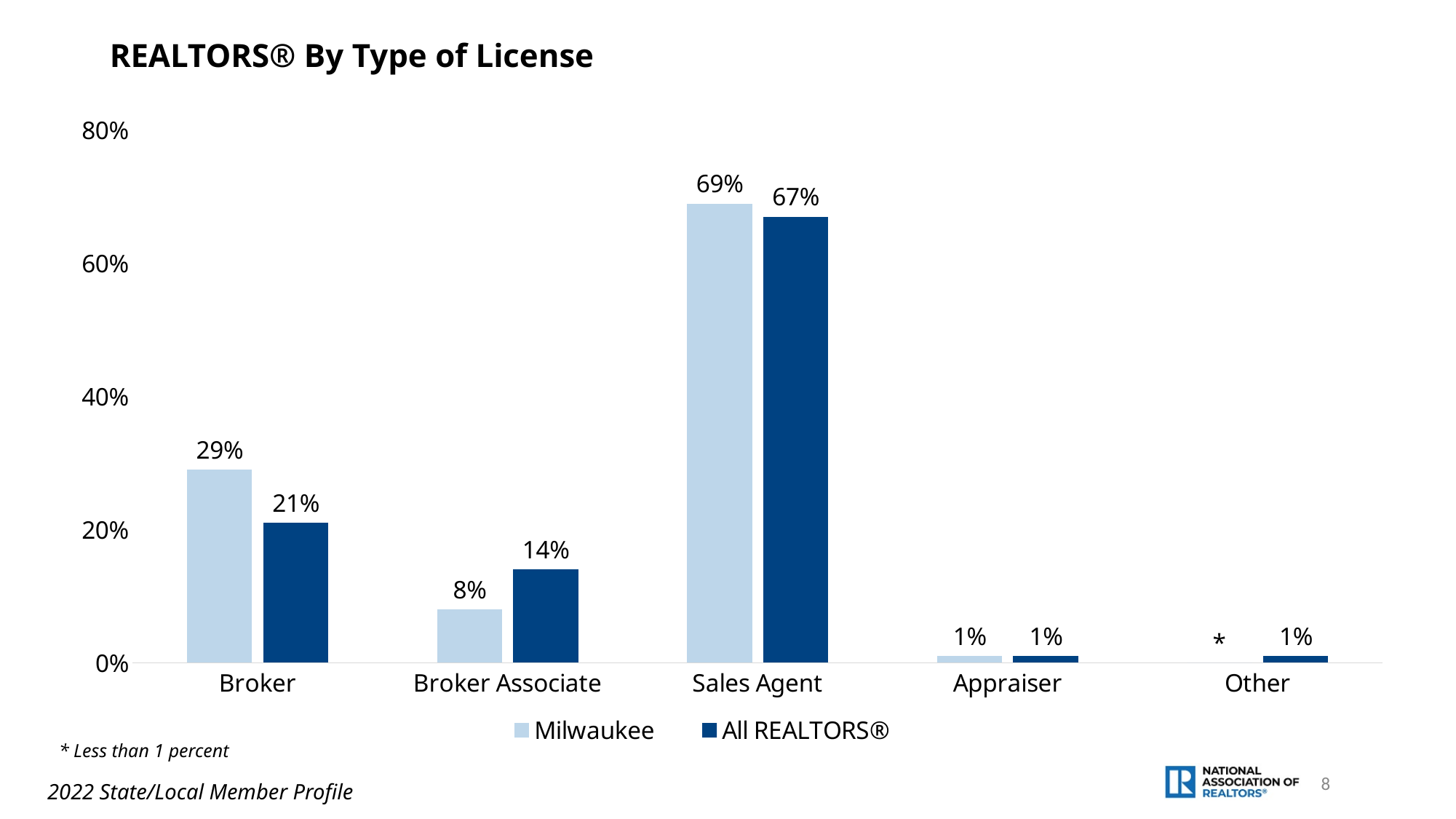
What is the Milwaukee value for Sales Agent? 69% What is the difference between the Milwaukee and All REALTORS® values for Broker? 8 percentage points Which is larger for Broker Associate: Milwaukee or All REALTORS®? All REALTORS® What percentage of Milwaukee REALTORS® hold a Broker license? 29% What is the All REALTORS® value for Appraiser? 1% What does the asterisk shown for the Milwaukee value in the Other category mean? Less than 1 percent Which license type has the highest value for Milwaukee? Sales Agent Which license type has the lowest value for All REALTORS®? Appraiser and Other (both 1%) How many series does the legend list? 2 How many license type categories are shown on the x axis? 5 What is the value for All REALTORS® in the Broker Associate category? 14% What kind of chart is shown on the slide? Bar chart